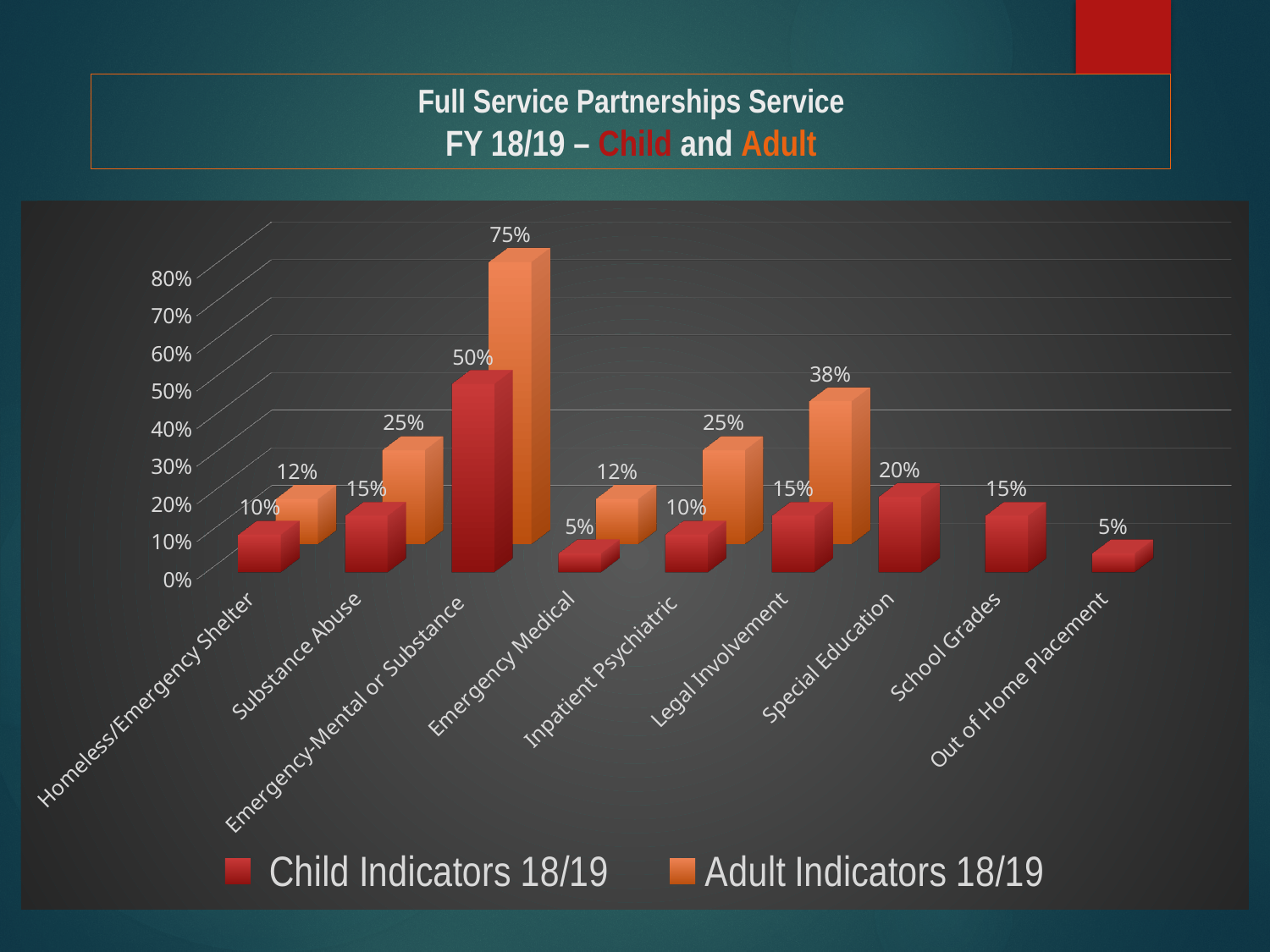
Which category has the highest Child Indicators 18/19 value? Emergency-Mental or Substance For Substance Abuse, which is larger: the Child Indicators 18/19 value or the Adult Indicators 18/19 value? Adult Indicators 18/19 What is the Child Indicators 18/19 value for Special Education? 20% What kind of chart is shown on the slide? Bar chart How many series does the legend list? 2 What is the Adult Indicators 18/19 value for Homeless/Emergency Shelter? 12% Which category has the highest Adult Indicators 18/19 value? Emergency-Mental or Substance How many categories are shown on the x axis? 9 What is the difference between the Adult and Child Indicators 18/19 values for Legal Involvement? 23% What is the Child Indicators 18/19 value for Emergency-Mental or Substance? 50% What is the difference between the Adult and Child Indicators 18/19 values for Emergency-Mental or Substance? 25% What is the Adult Indicators 18/19 value for Legal Involvement? 38%